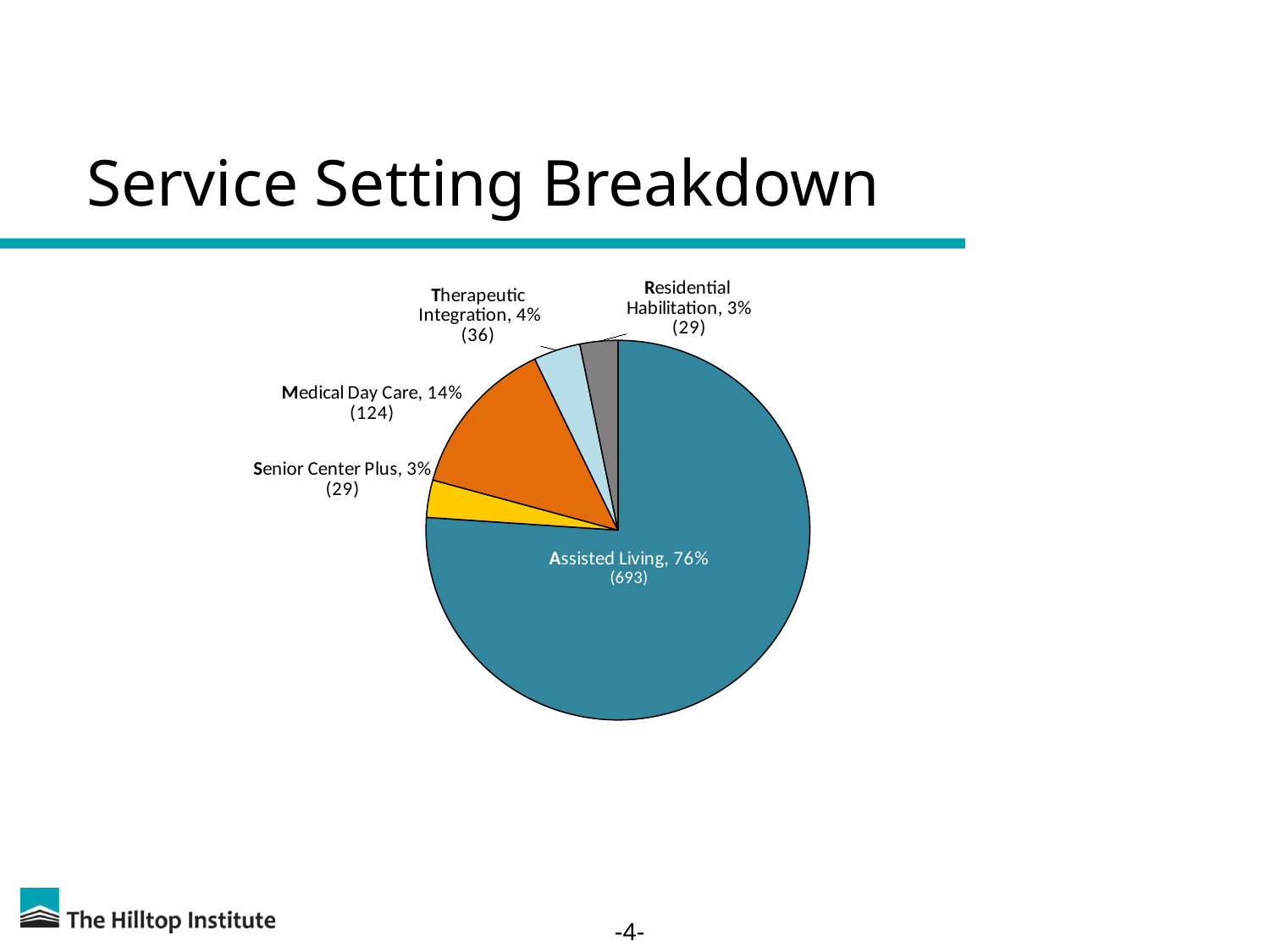
Which is larger, the count for Therapeutic Integration or the count for Senior Center Plus? Therapeutic Integration How many service setting categories are shown in the pie chart? 5 What is the difference in count between Assisted Living and Medical Day Care? 569 What is the difference in count between Medical Day Care and Therapeutic Integration? 88 What percentage share does Medical Day Care have? 14% What kind of chart is shown on the slide? Pie chart What is the count shown for Therapeutic Integration? 36 What is the title of the slide containing the pie chart? Service Setting Breakdown What percentage share does Assisted Living have in the pie chart? 76% What is the count shown for Medical Day Care? 124 Which service setting has the largest slice of the pie? Assisted Living What is the count shown for Residential Habilitation? 29